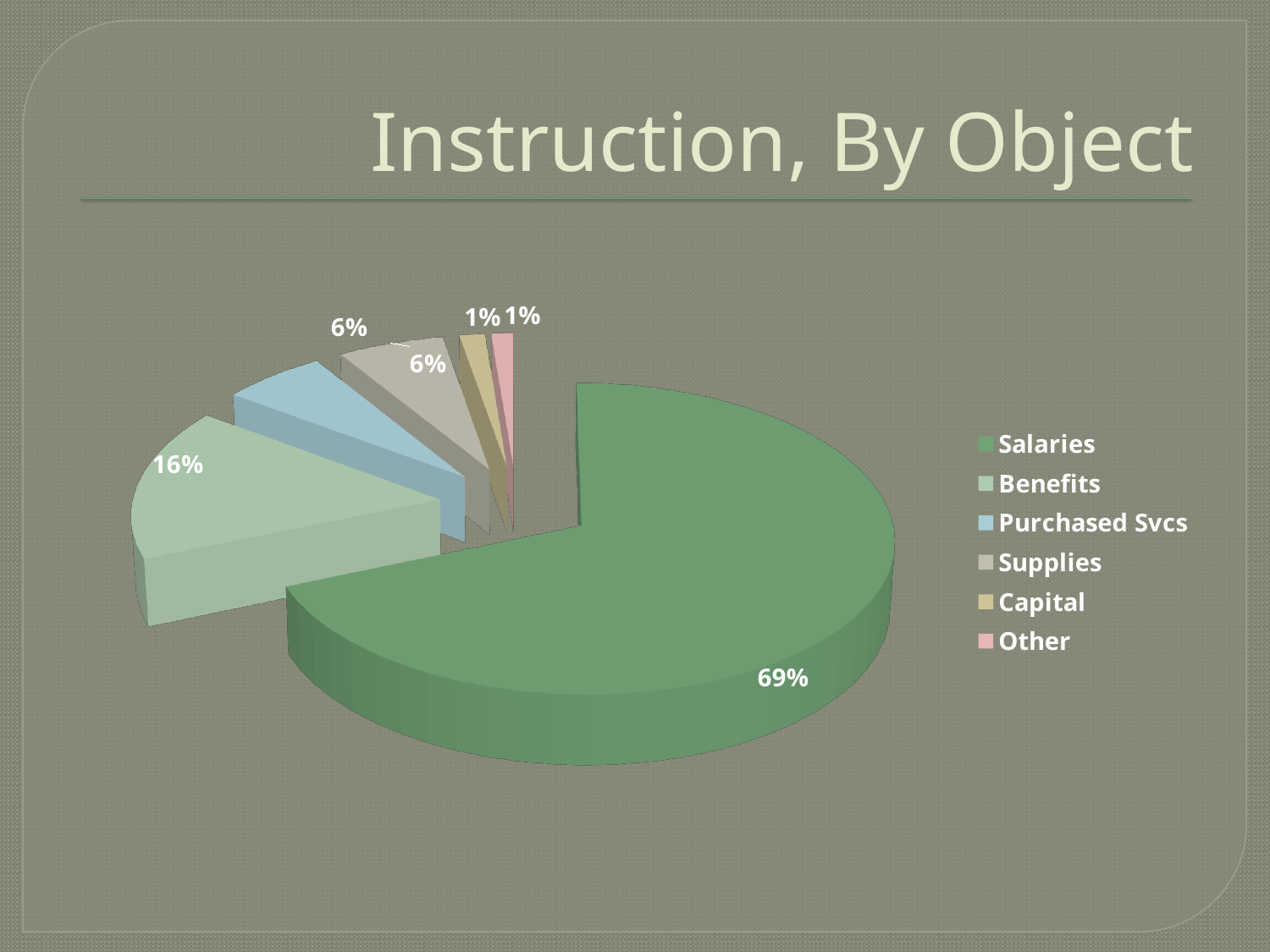
What is the difference in percentage points between Salaries and Benefits? 53 What percentage is shown for Purchased Svcs? 6% What is the combined percentage of Capital and Other? 2% What percentage is shown for Benefits? 16% How many categories does the pie chart show? 6 What kind of chart is shown on the slide? Pie chart What is the title of the chart? Instruction, By Object Which is larger, Benefits or Supplies? Benefits What percentage is shown for Capital? 1% Which category has the largest slice of the pie? Salaries Which legend entry is listed last? Other What share of the pie does Salaries account for? 69%